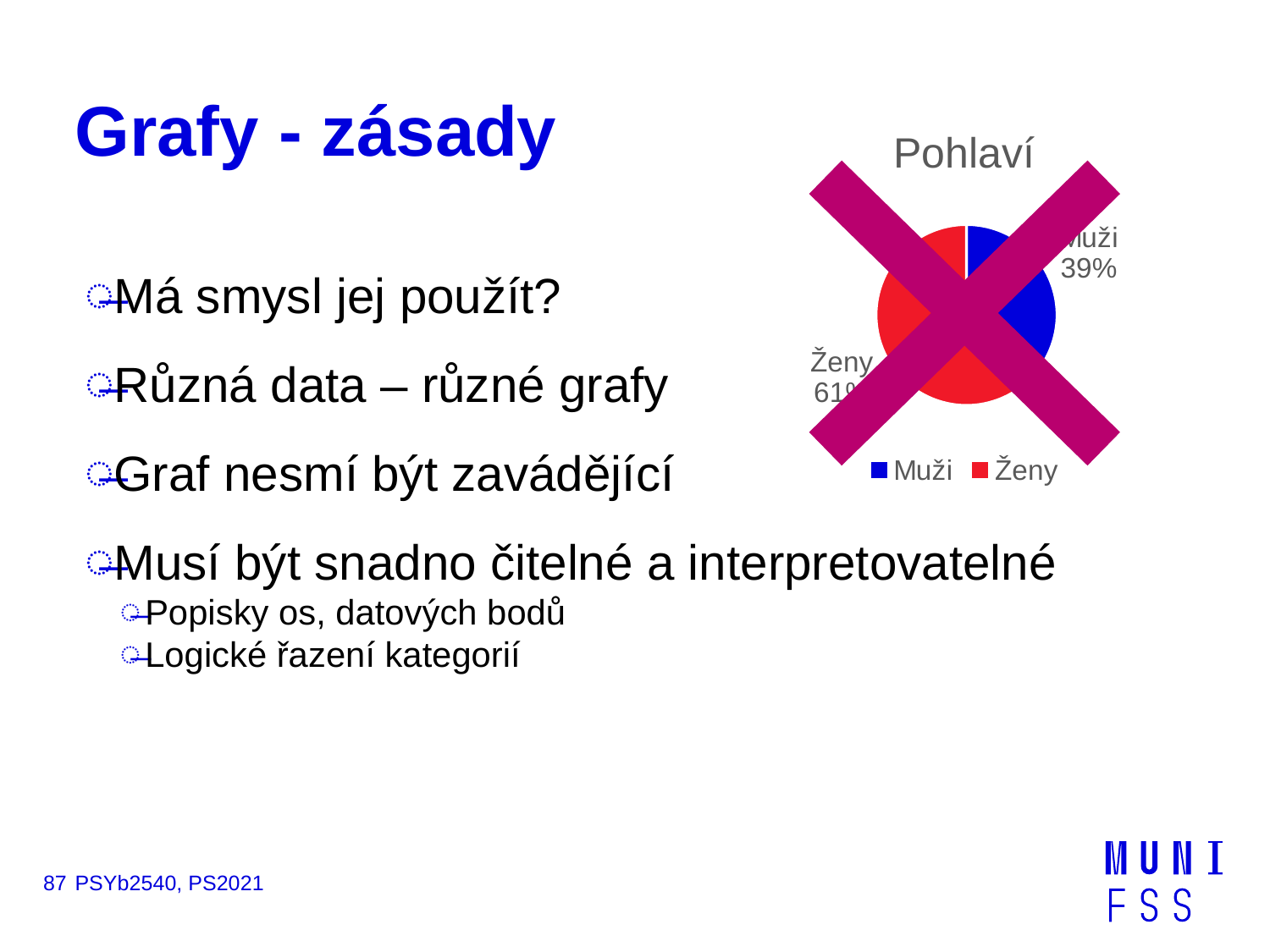
Is the share for Muži greater or less than 50%? less What percentage of the pie chart is Muži? 39% What is the title of the chart? Pohlaví How many entries does the chart legend list? 2 How many categories does the pie chart have? 2 What kind of chart is shown on the slide? pie chart Which category has the largest slice in the pie chart? Ženy Which category has the smallest slice in the pie chart? Muži What colour is the Ženy slice in the pie chart? red Which slice is larger, Muži or Ženy? Ženy